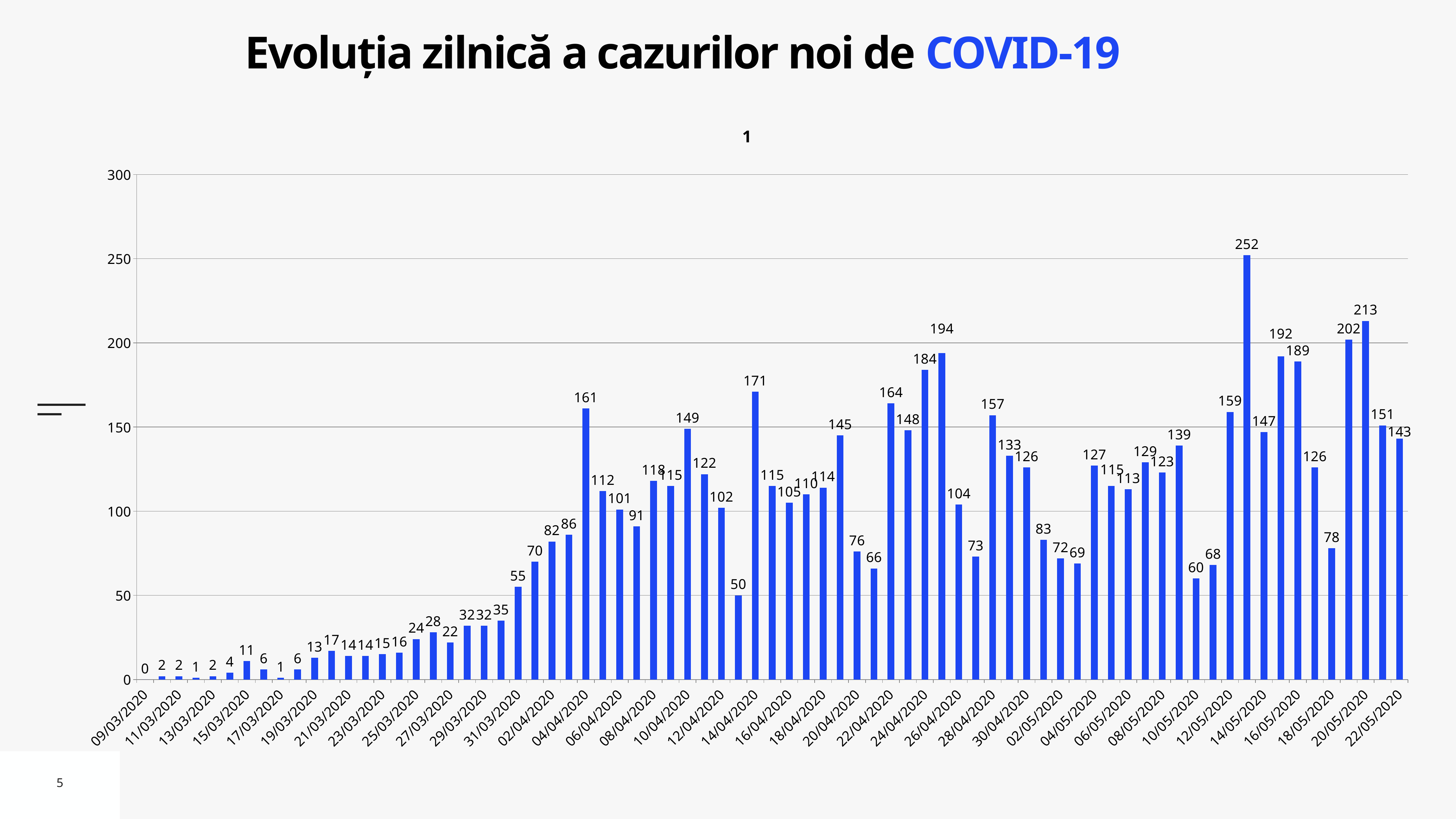
What is the highest daily value shown in the chart? 252 What is the maximum value shown on the vertical axis? 300 Is the value for 12/05/2020 greater or less than 150? greater What is the difference between the values for 20/05/2020 and 22/05/2020? 70 What is the value for 09/03/2020? 0 Overall, do the values rise or fall from 09/03/2020 to 22/05/2020? rise What kind of chart is shown on the slide? bar chart Which date has the larger value, 04/04/2020 or 14/04/2020? 14/04/2020 What is the title of the chart on the slide? Evoluția zilnică a cazurilor noi de COVID-19 What is the value for 20/05/2020? 213 What is the value for 22/05/2020? 143 What is the value for 14/04/2020? 171